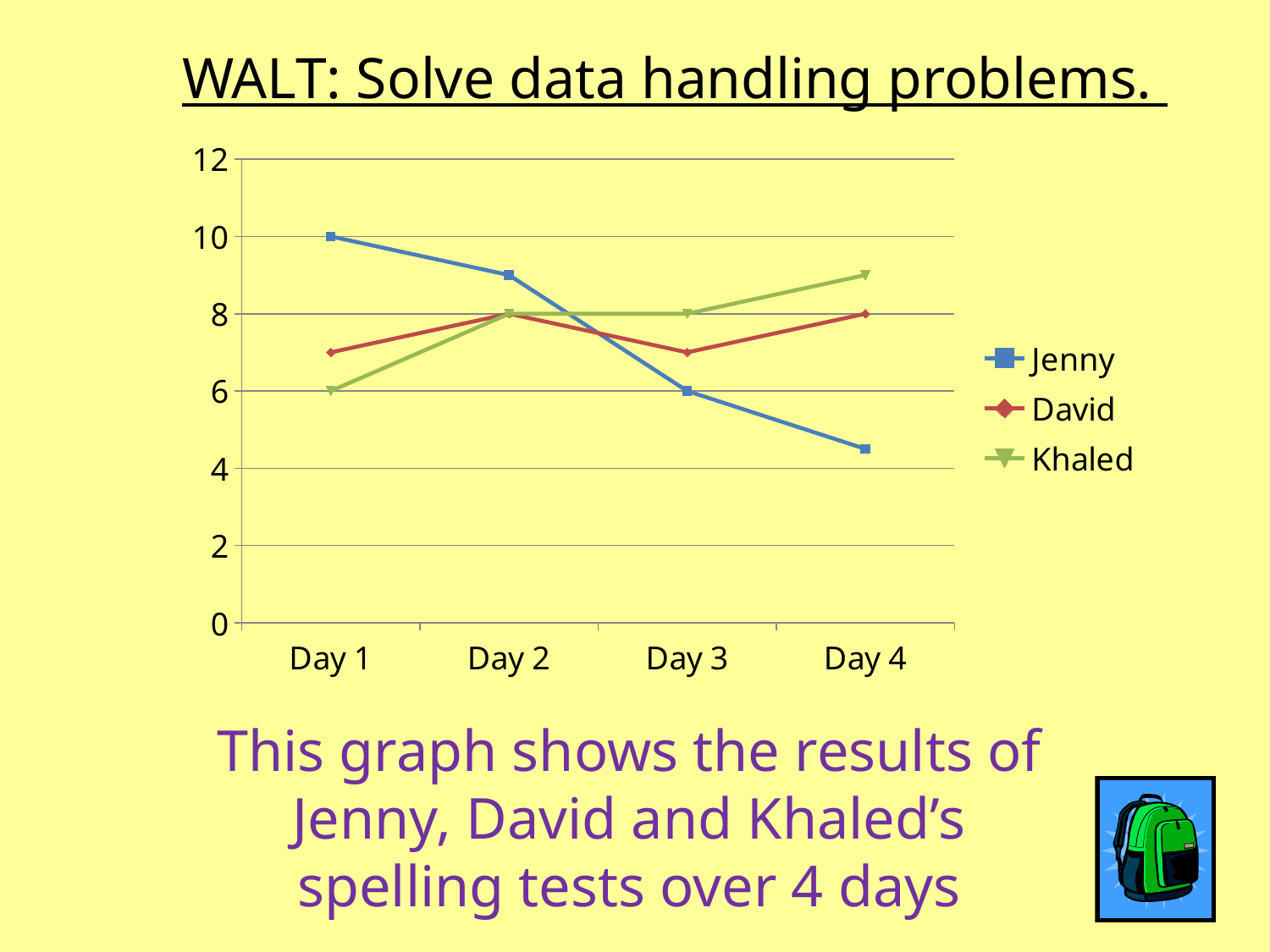
Is Jenny's score on Day 4 greater or less than 6? less By how much did Jenny's score fall from Day 1 to Day 3? 4 Who had the highest score on Day 4? Khaled What was David's score on Day 4? 8 Is David's score on Day 1 greater or less than 6? greater How many days are shown on the x axis? 4 Do Jenny's scores rise or fall from Day 1 to Day 4? fall How many series does the legend list? 3 What kind of chart is shown on the slide? line chart What was Khaled's score on Day 1? 6 What was Jenny's score on Day 1? 10 What was Jenny's score on Day 3? 6